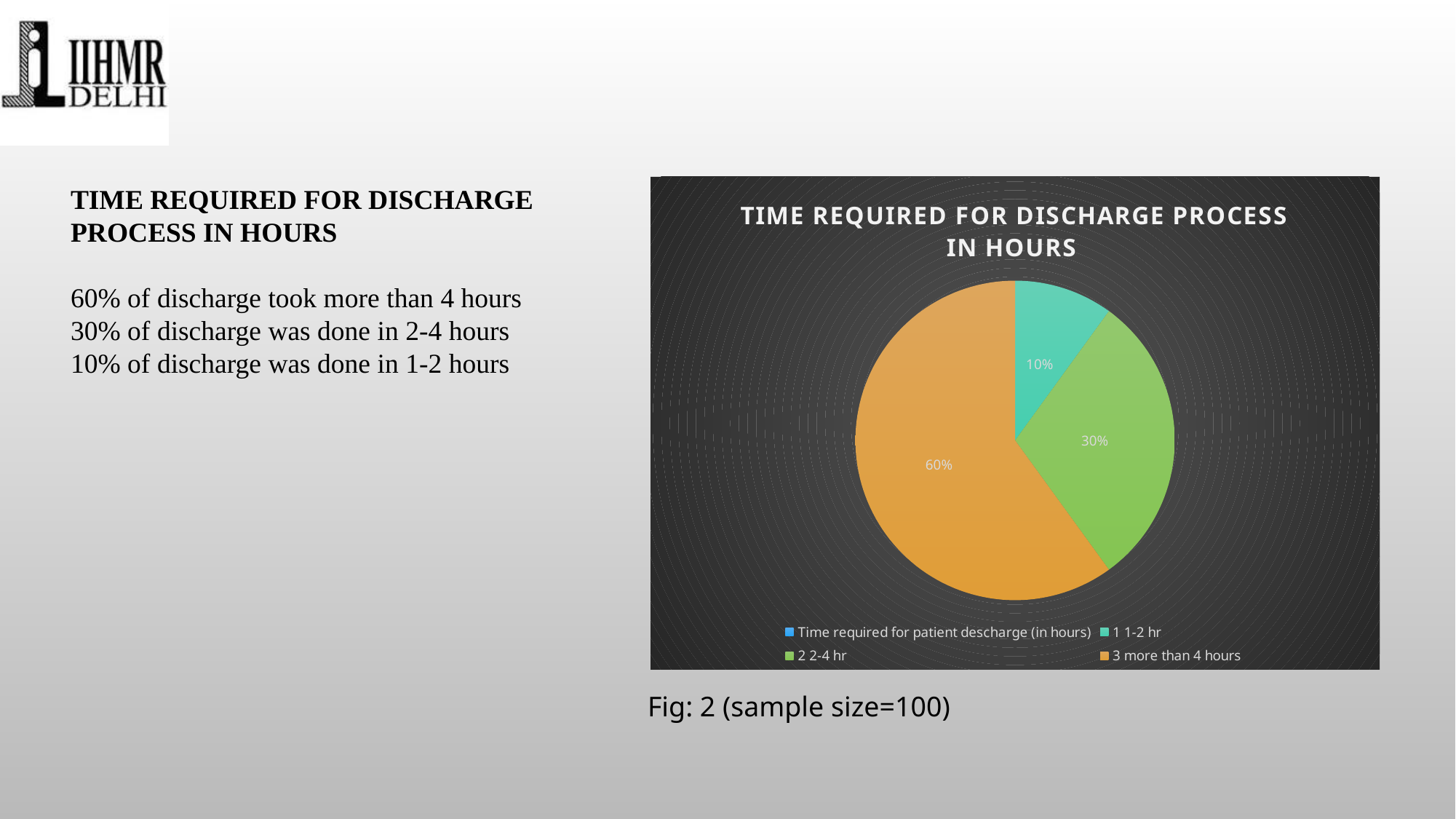
What share of the pie does the '1-2 hr' slice represent? 10% Which category has the largest slice of the pie? 3 more than 4 hours Which slice is larger, '2-4 hr' or '1-2 hr'? 2 2-4 hr What is the difference in percentage points between the '2-4 hr' slice and the '1-2 hr' slice? 20 What share of the pie does the 'more than 4 hours' slice represent? 60% What kind of chart is shown on the slide? pie chart Which category has the smallest slice of the pie? 1 1-2 hr What share of the pie does the '2-4 hr' slice represent? 30% How many slices does the pie chart show? 3 What is the title of the chart? TIME REQUIRED FOR DISCHARGE PROCESS IN HOURS What colour is the 'more than 4 hours' slice? orange What is the difference in percentage points between the 'more than 4 hours' slice and the '2-4 hr' slice? 30